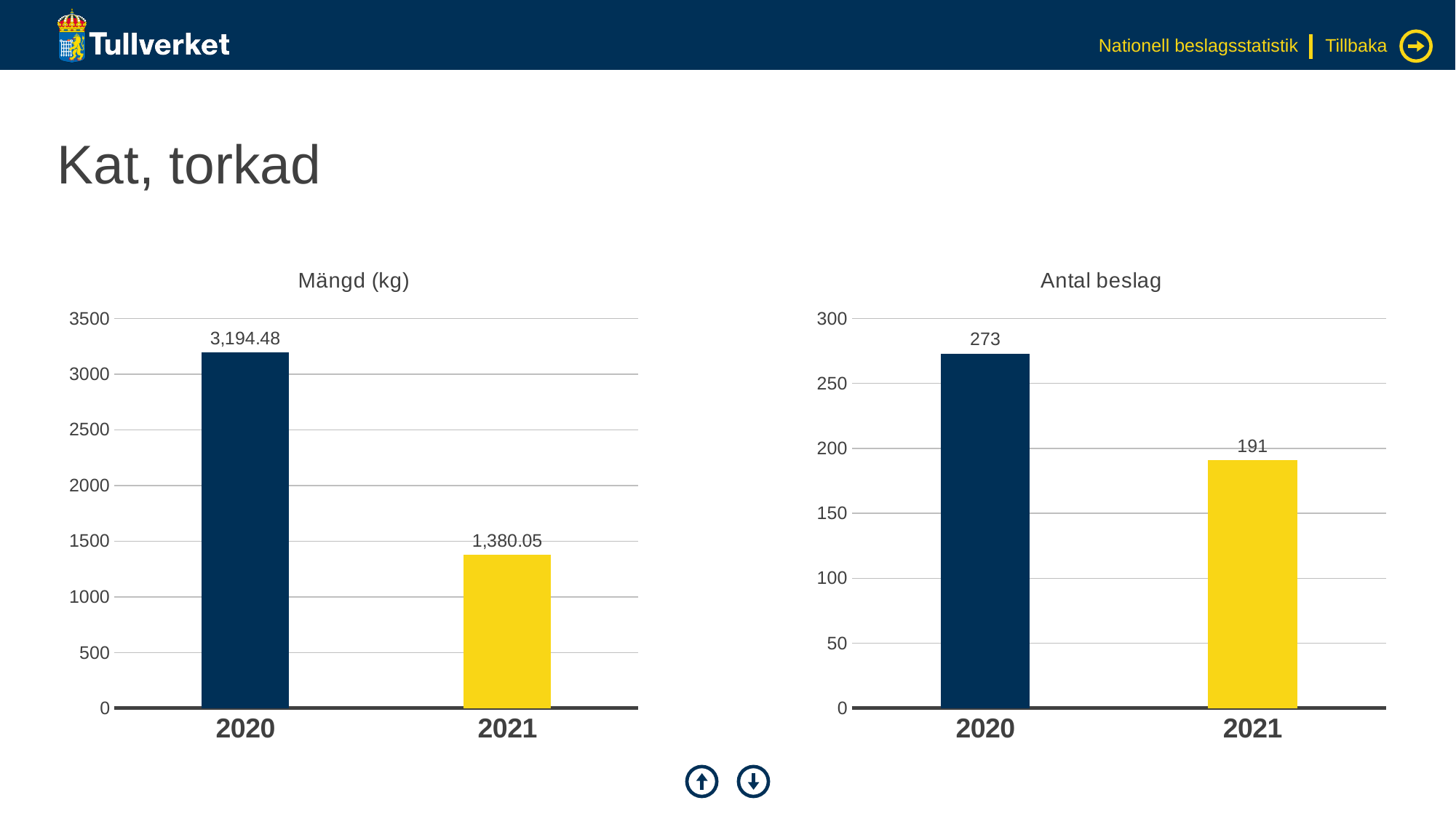
In the 'Antal beslag' chart, what is the difference between the 2020 and 2021 values? 82 In the 'Mängd (kg)' chart, do the values rise or fall from 2020 to 2021? fall In the 'Mängd (kg)' chart, what is the value for 2021? 1,380.05 In the 'Mängd (kg)' chart, which year has the highest value? 2020 In the 'Antal beslag' chart, what is the value for 2021? 191 In the 'Mängd (kg)' chart, what is the value for 2020? 3,194.48 How many categories are shown in the 'Mängd (kg)' chart? 2 What kind of chart is the 'Antal beslag' chart? bar chart In the 'Antal beslag' chart, what is the value for 2020? 273 In the 'Antal beslag' chart, is the value for 2021 greater or less than 200? less In the 'Antal beslag' chart, which year has the lowest value? 2021 In the 'Mängd (kg)' chart, what is the difference between the 2020 and 2021 values? 1,814.43